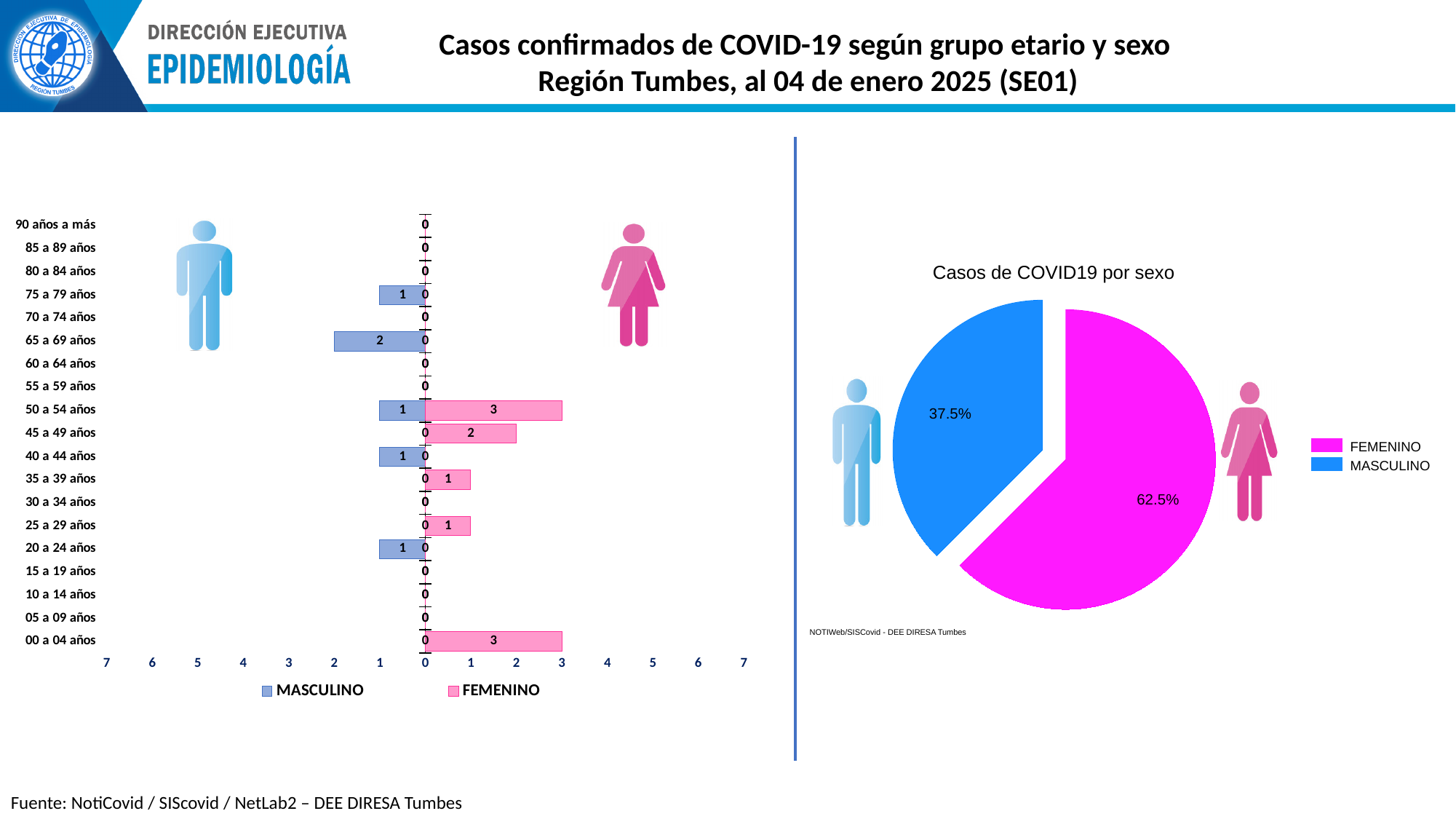
How many series does the legend of the left chart list? 2 What kind of chart is the left chart? Bar chart In the left chart, how many MASCULINO cases are shown for the 20 a 24 años group? 1 In the left chart, how many MASCULINO cases are shown for the 65 a 69 años group? 2 In the left chart, what is the difference between the FEMENINO and MASCULINO values for the 50 a 54 años group? 2 In the pie chart 'Casos de COVID19 por sexo', what share is FEMENINO? 62.5% In the pie chart 'Casos de COVID19 por sexo', which colour represents MASCULINO? Blue In the pie chart 'Casos de COVID19 por sexo', what share is MASCULINO? 37.5% In the left chart, which is larger: the FEMENINO value for 00 a 04 años or the FEMENINO value for 35 a 39 años? 00 a 04 años In the left chart, which age group has the highest MASCULINO value? 65 a 69 años In the left chart, how many FEMENINO cases are shown for the 45 a 49 años group? 2 In the left chart, how many FEMENINO cases are shown for the 50 a 54 años group? 3